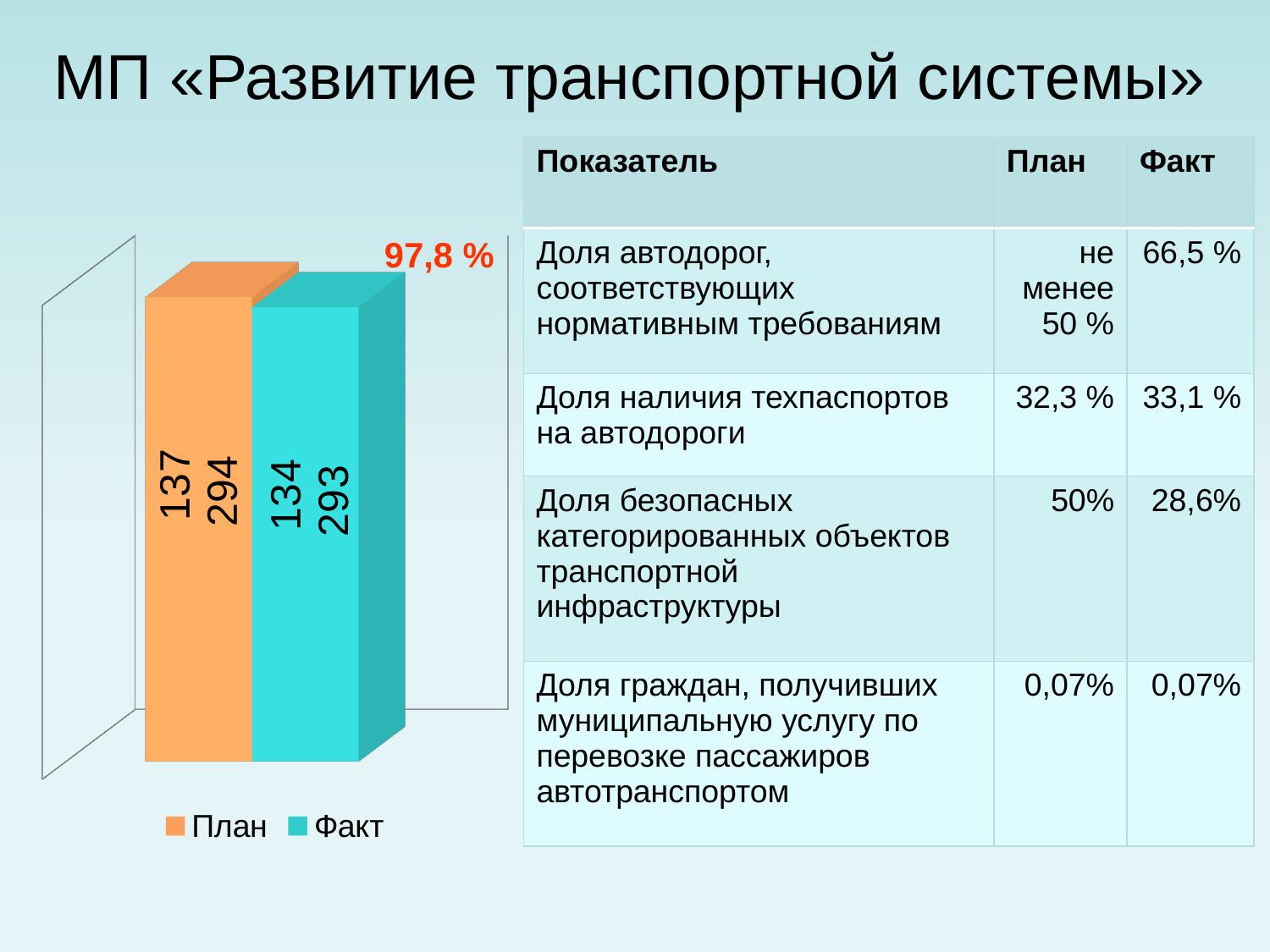
Which series has the highest value in the chart? План Which bar is taller in the chart, План or Факт? План What percentage is printed in red above the bars in the chart? 97,8 % How many bars are plotted in the chart? 2 What kind of chart is shown on the left of the slide? Bar chart Which colour represents Факт in the chart legend? Teal How many series does the chart legend list? 2 Which series has the lowest value in the chart? Факт What is the value of the Факт bar in the chart? 134 293 What is the value of the План bar in the chart? 137 294 What is the difference between the План and Факт values in the chart? 3 001